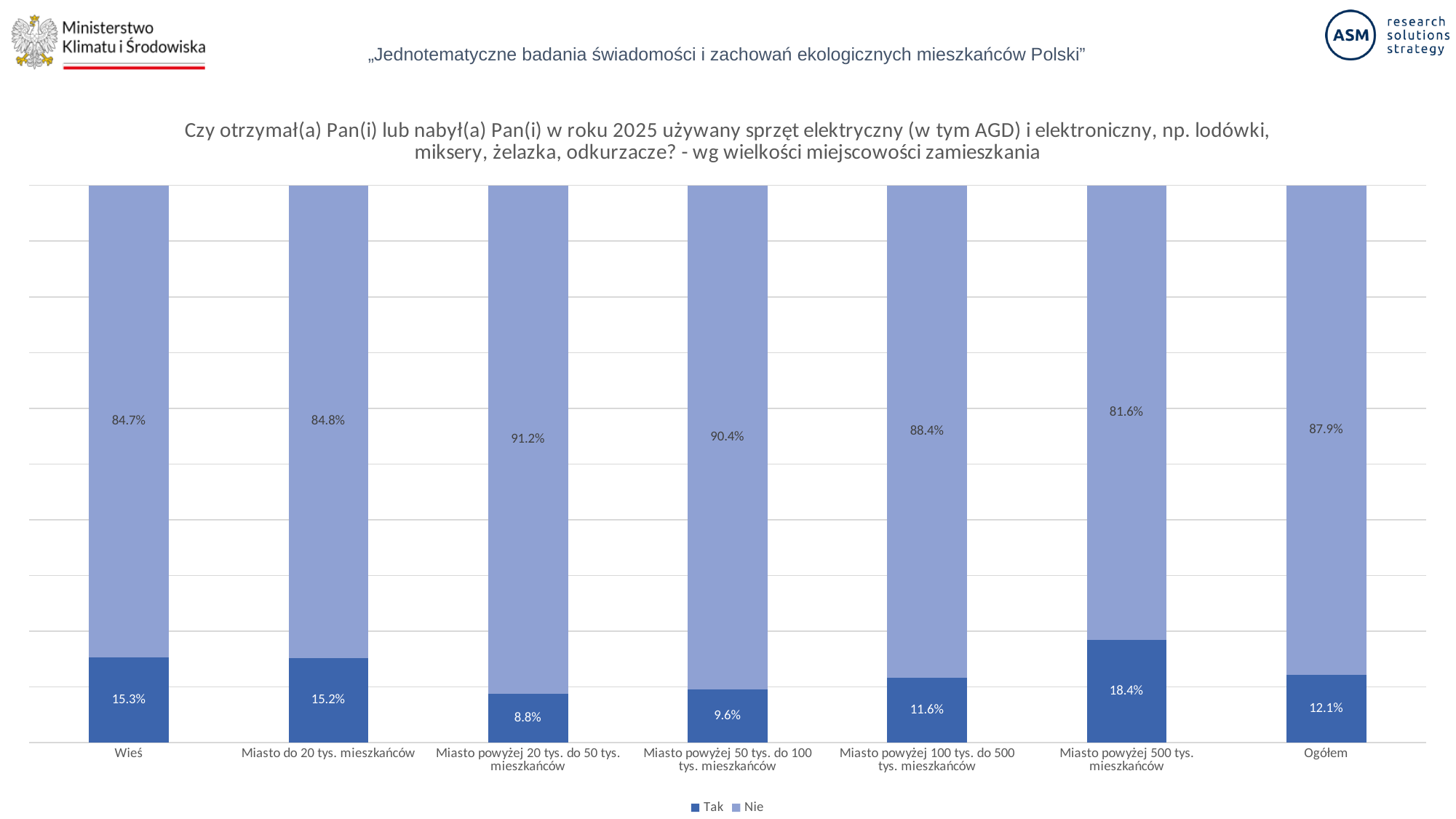
How many categories are shown on the x axis? 7 What is the value for "Nie" for Miasto powyżej 500 tys. mieszkańców? 81.6% What is the total of the stacked bar for Wieś? 100% What is the value for "Tak" for Wieś? 15.3% What is the value for "Tak" for Ogółem? 12.1% Which is larger: the "Tak" value for Miasto powyżej 100 tys. do 500 tys. mieszkańców or the "Tak" value for Miasto powyżej 50 tys. do 100 tys. mieszkańców? Miasto powyżej 100 tys. do 500 tys. mieszkańców What kind of chart is shown on the slide? Stacked bar chart How many series does the legend list? 2 What is the difference between the "Tak" value for Miasto powyżej 500 tys. mieszkańców and the "Tak" value for Wieś? 3.1 percentage points Which category has the lowest value for "Tak"? Miasto powyżej 20 tys. do 50 tys. mieszkańców What is the value for "Nie" for Miasto powyżej 20 tys. do 50 tys. mieszkańców? 91.2% Which category has the highest value for "Tak"? Miasto powyżej 500 tys. mieszkańców